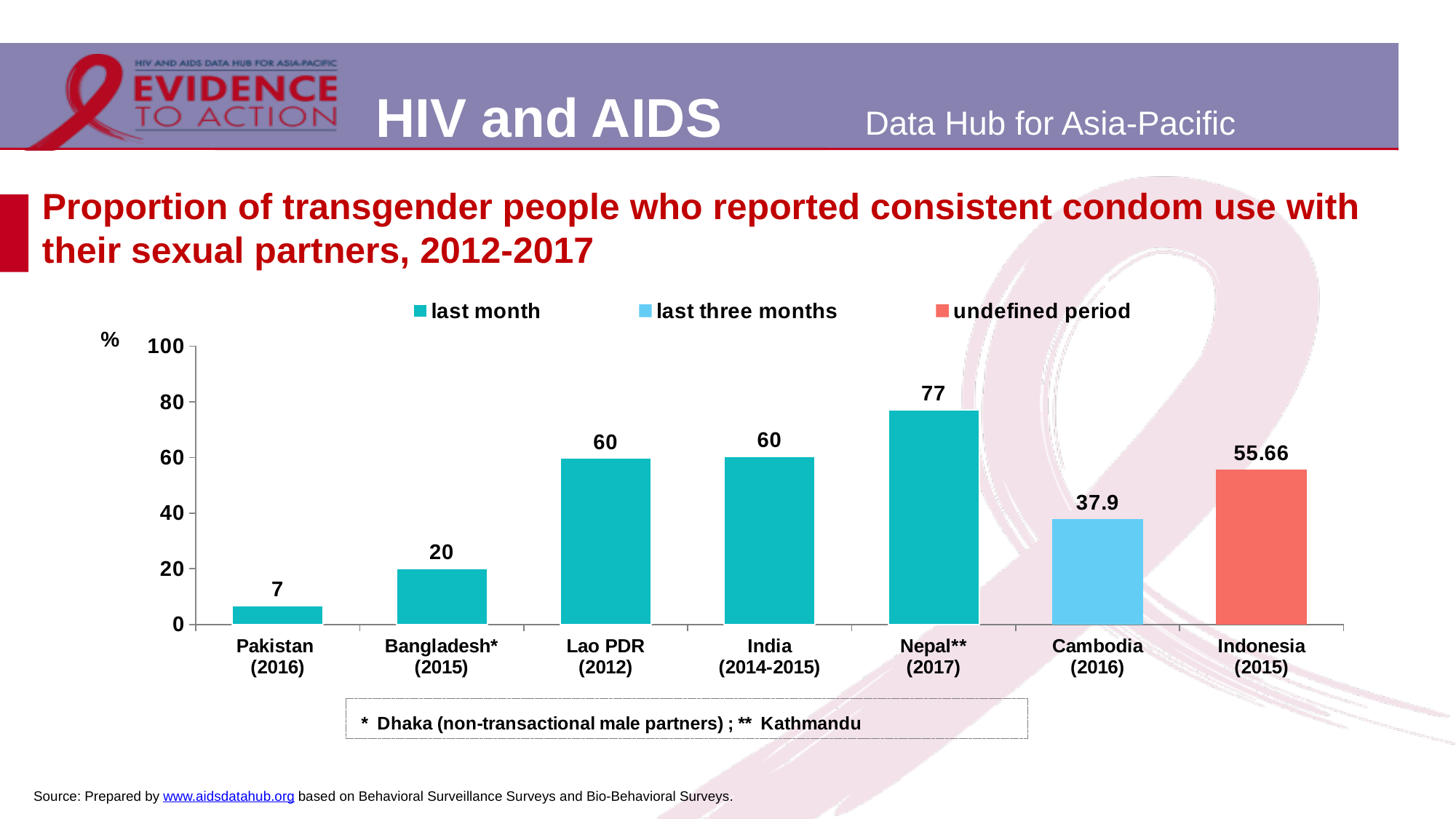
Which country has the lowest value? Pakistan (2016) What is the difference between the values for Nepal** (2017) and Pakistan (2016)? 70 What is the value for Nepal** (2017)? 77 Which is larger, the value for Bangladesh* (2015) or the value for Cambodia (2016)? Cambodia (2016) Which legend series does the Cambodia (2016) bar belong to? last three months What is the value for Cambodia (2016)? 37.9 What is the value for Indonesia (2015)? 55.66 What is the difference between the values for Indonesia (2015) and Cambodia (2016)? 17.76 How many countries are shown on the chart? 7 What kind of chart is shown? bar chart How many series does the legend list? 3 Which country has the highest value? Nepal** (2017)